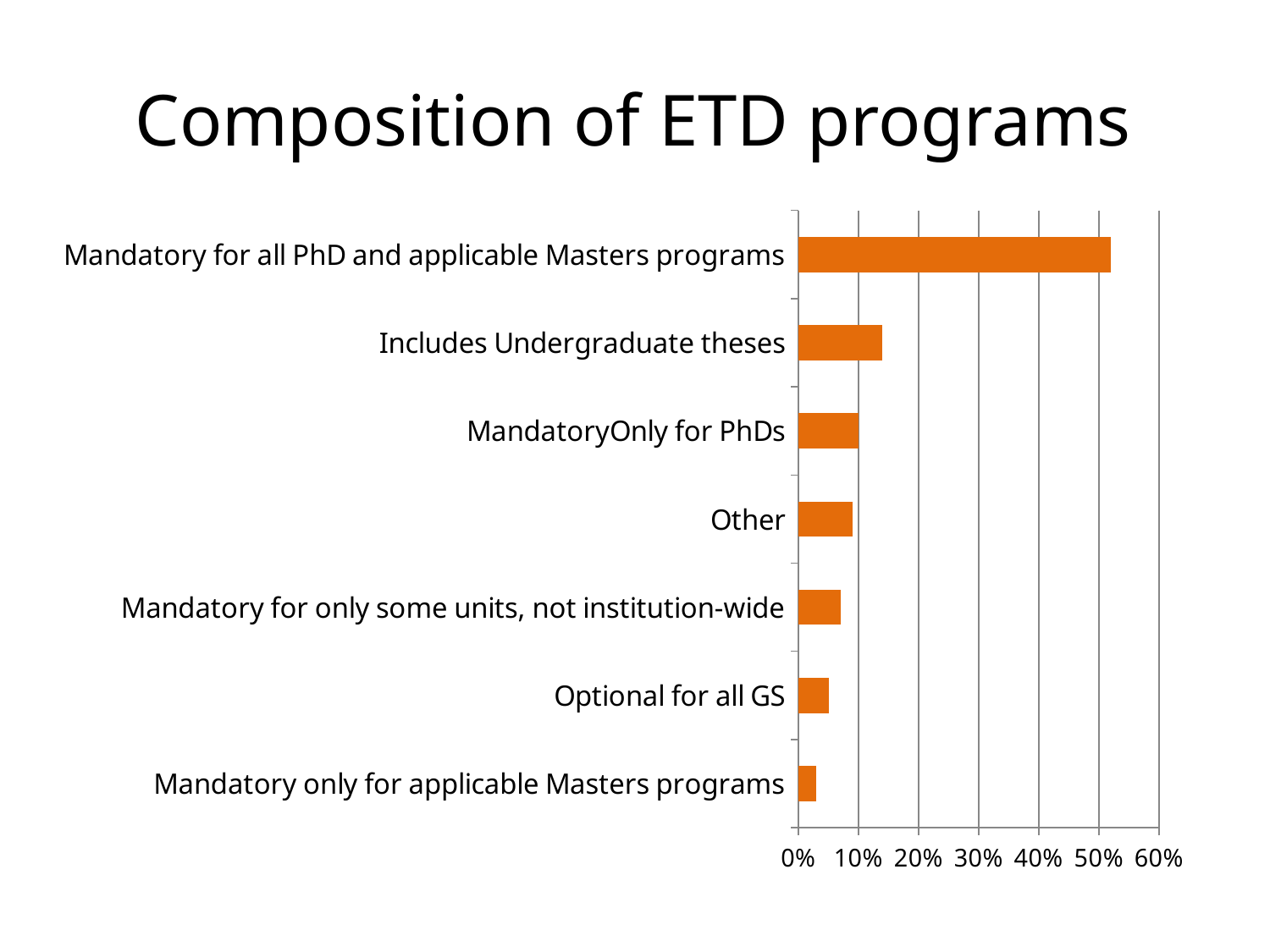
Which is larger: the value for "Other" or the value for "Optional for all GS"? Other Is the value for "Mandatory for all PhD and applicable Masters programs" greater or less than 40%? greater Which category has the lowest value? Mandatory only for applicable Masters programs What is the title of the chart? Composition of ETD programs How many categories are plotted in the chart? 7 Is the value for "Mandatory for only some units, not institution-wide" greater or less than 10%? less Which category has the highest value? Mandatory for all PhD and applicable Masters programs Is the value for "Optional for all GS" greater or less than 10%? less What kind of chart is shown on the slide? bar chart What is the maximum value shown on the horizontal axis? 60% Which is larger: the value for "Includes Undergraduate theses" or the value for "MandatoryOnly for PhDs"? Includes Undergraduate theses